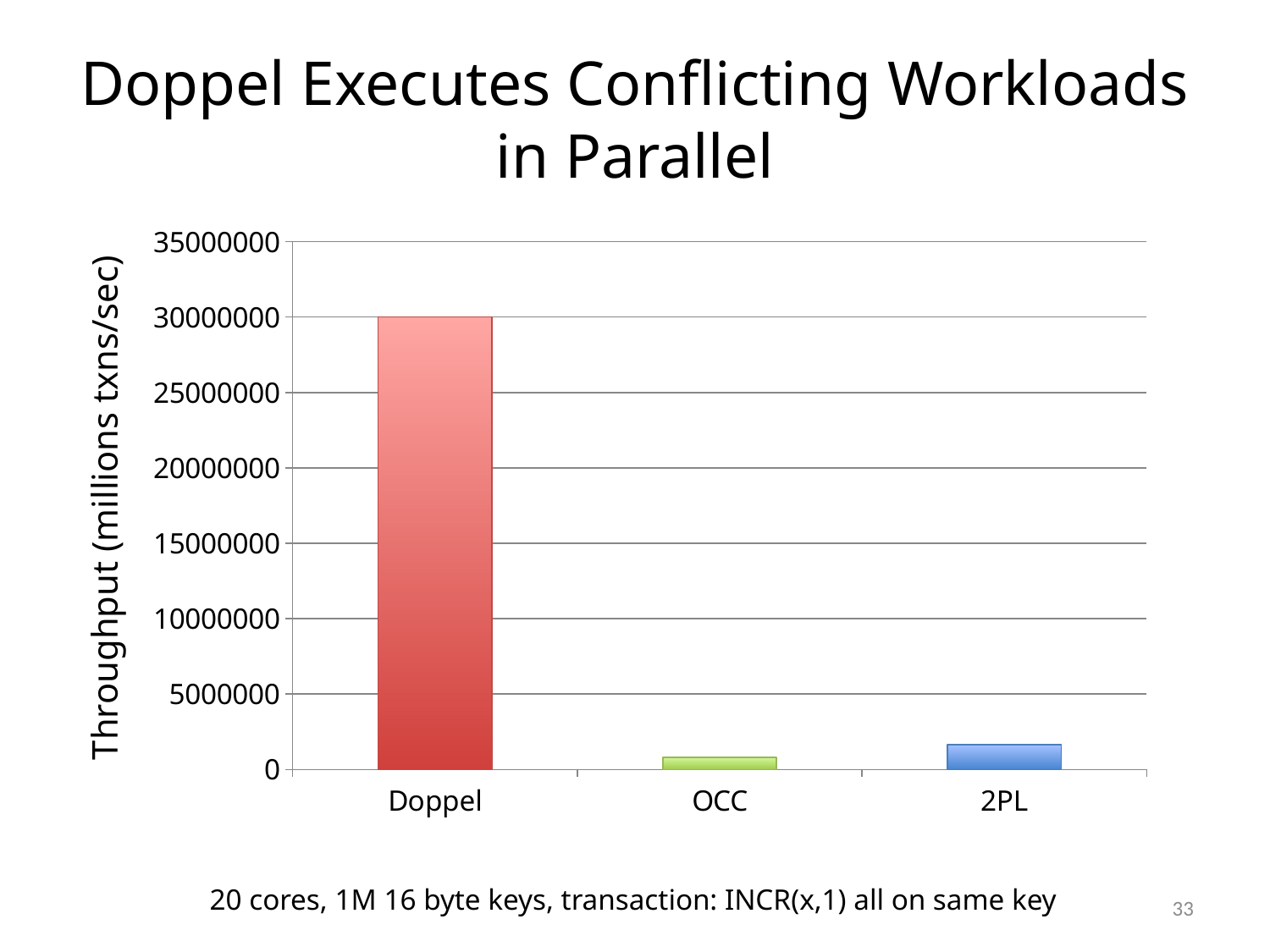
How many categories are plotted on the x axis? 3 Is the value for Doppel greater or less than 25000000? greater What kind of chart is shown on the slide? bar chart What is the throughput value for Doppel? 30000000 Is the value for 2PL greater or less than 5000000? less Which has a larger throughput, 2PL or OCC? 2PL Which has a larger throughput, Doppel or OCC? Doppel What is the label of the y axis? Throughput (millions txns/sec) Which category has the lowest throughput? OCC Is the value for OCC greater or less than 5000000? less What colour is the bar for 2PL? blue Which category has the highest throughput? Doppel